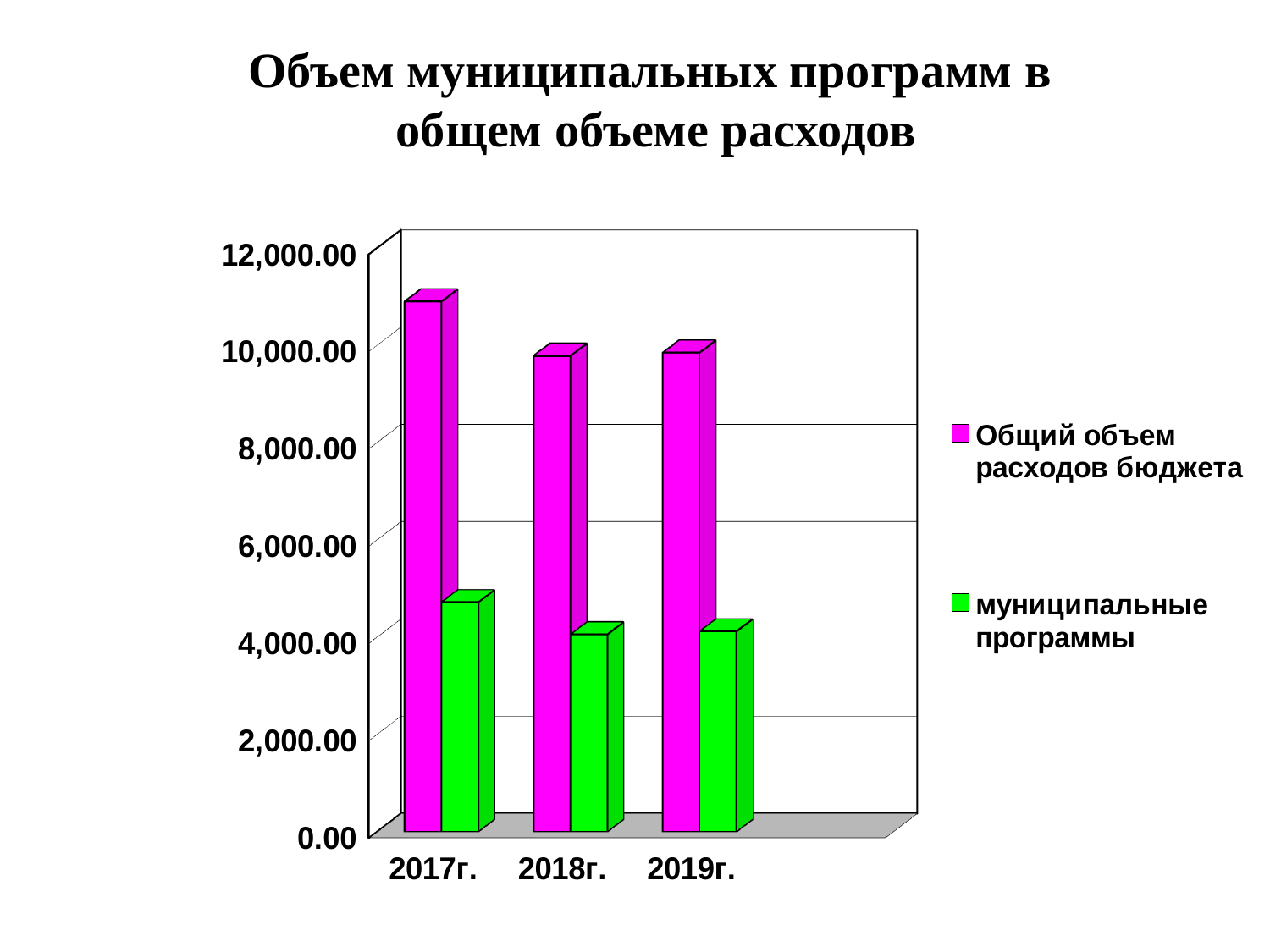
Is the value for муниципальные программы in 2019г. greater or less than 6,000.00? less Is the value for муниципальные программы in 2017г. greater or less than 4,000.00? greater What colour are the bars for муниципальные программы? green How many years are shown on the x axis? 3 What kind of chart is shown on the slide? bar chart Which year has the highest value for муниципальные программы? 2017г. Which is larger: Общий объем расходов бюджета in 2017г. or in 2018г.? 2017г. How many series does the legend list? 2 Does the value for Общий объем расходов бюджета rise or fall from 2017г. to 2018г.? fall Which year has the highest value for Общий объем расходов бюджета? 2017г. Is the value for Общий объем расходов бюджета in 2017г. greater or less than 10,000.00? greater